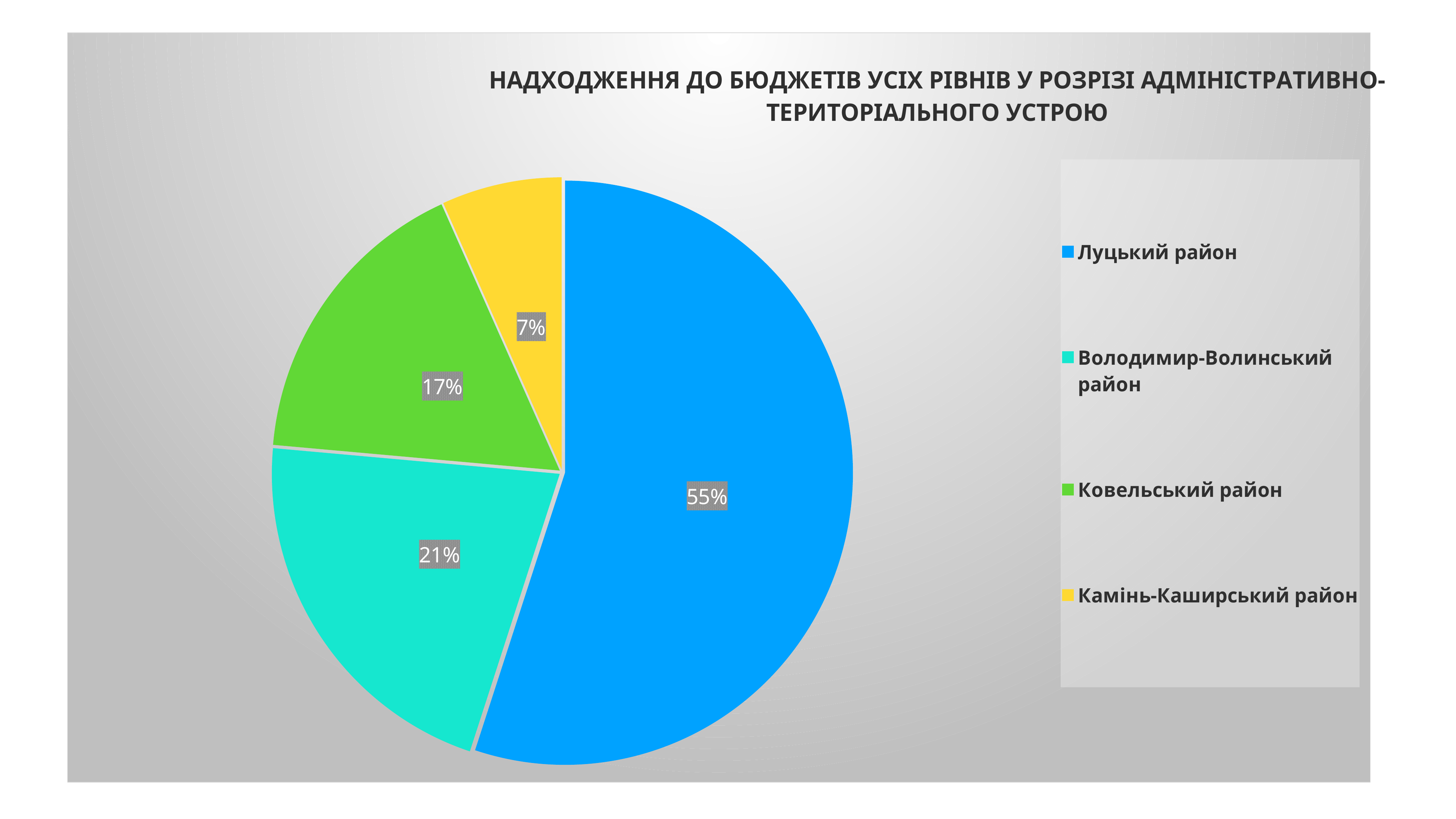
What kind of chart is shown on the slide? Pie chart What share of the pie does Володимир-Волинський район have? 21% What share of the pie does Ковельський район have? 17% What colour is the slice for Камінь-Каширський район? Yellow What is the difference in percentage points between Ковельський район and Камінь-Каширський район? 10 How many districts are shown in the pie chart? 4 Which district has the smallest slice of the pie? Камінь-Каширський район What share of the pie does Камінь-Каширський район have? 7% Which has a larger share, Володимир-Волинський район or Ковельський район? Володимир-Волинський район Which district has the largest slice of the pie? Луцький район What is the difference in percentage points between Луцький район and Володимир-Волинський район? 34